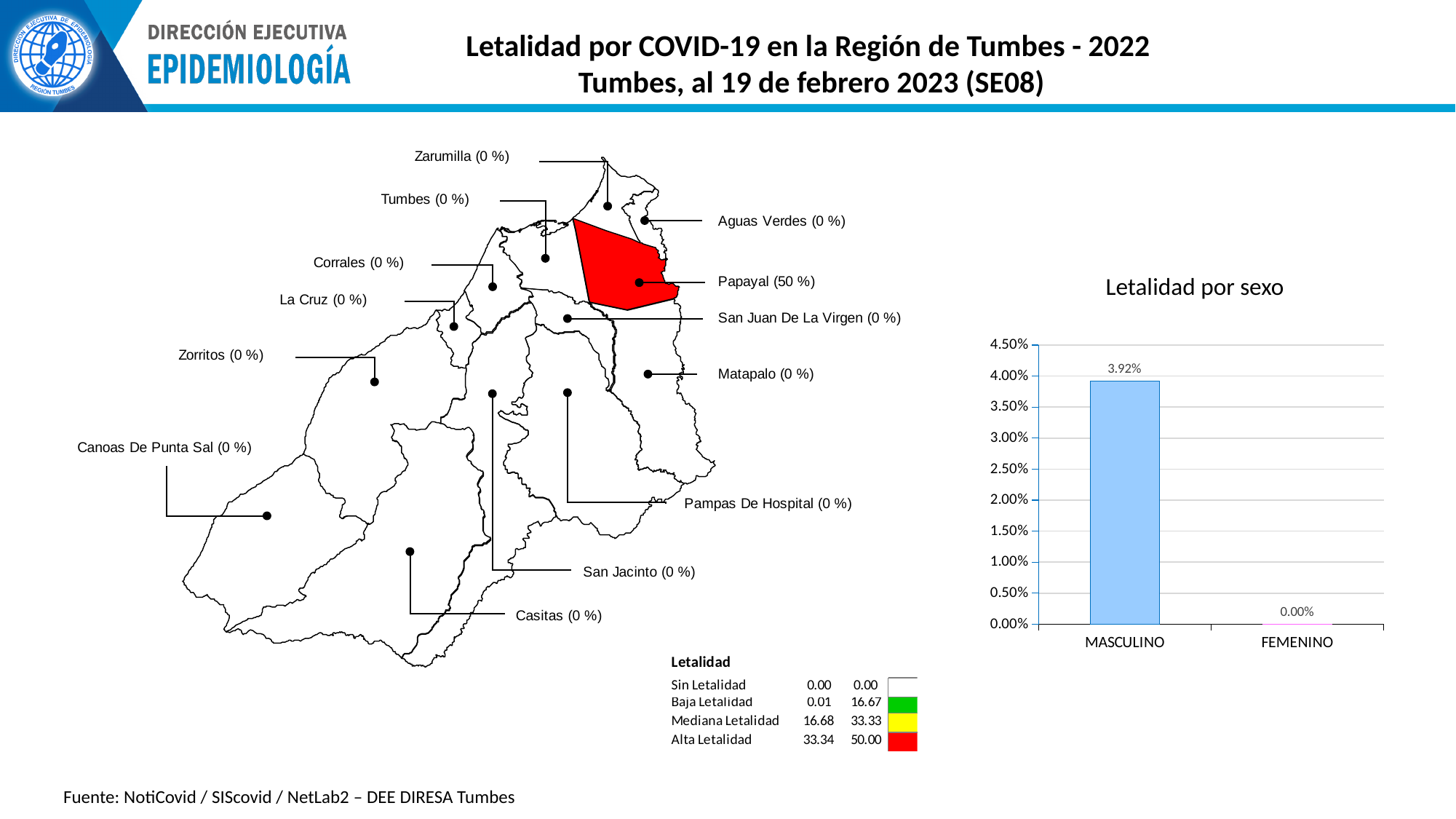
In the 'Letalidad por sexo' chart, which category has the highest value? MASCULINO How many categories are shown on the x axis of the 'Letalidad por sexo' chart? 2 On the map on the left, which district has the highest lethality value? Papayal In the 'Letalidad por sexo' chart, what is the value for MASCULINO? 3.92% In the 'Letalidad por sexo' chart, what is the difference between the MASCULINO and FEMENINO values? 3.92% In the 'Letalidad por sexo' chart, which is larger, the value for MASCULINO or for FEMENINO? MASCULINO In the 'Letalidad por sexo' chart, is the value for MASCULINO greater or less than 4.00%? less What is the highest tick value shown on the y axis of the 'Letalidad por sexo' chart? 4.50% In the 'Letalidad por sexo' chart, which category has the lowest value? FEMENINO On the map on the left, what lethality value is shown for Papayal? 50 % What kind of chart is 'Letalidad por sexo'? bar chart In the 'Letalidad por sexo' chart, what is the value for FEMENINO? 0.00%